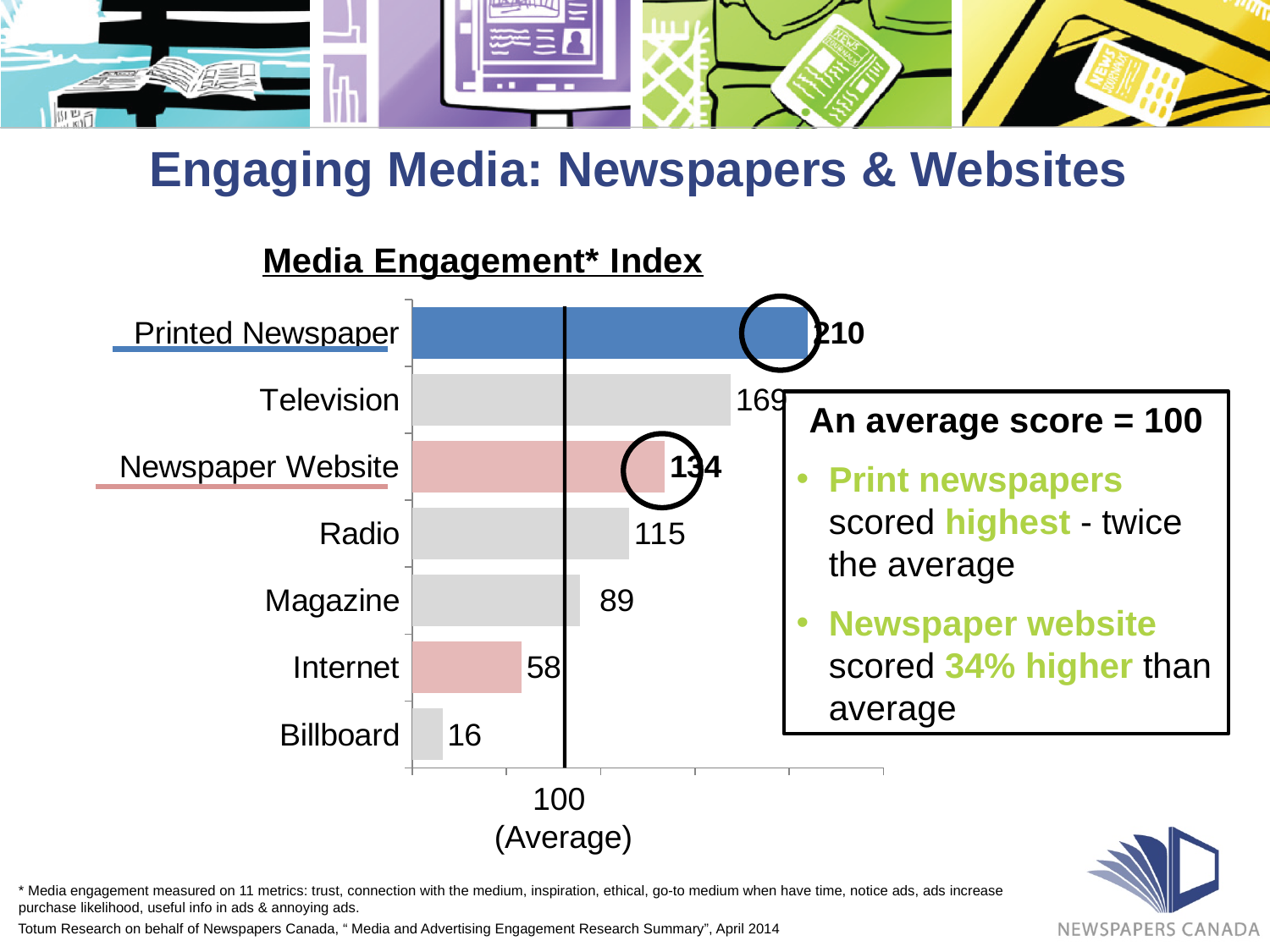
Which medium has the lowest Media Engagement Index? Billboard What is the Media Engagement Index value for Billboard? 16 What is the Media Engagement Index value for Printed Newspaper? 210 How many media categories are shown in the Media Engagement Index chart? 7 What value does the vertical line on the chart mark? 100 (Average) Is the Media Engagement Index value for Magazine greater or less than 100? less What is the Media Engagement Index value for Radio? 115 What type of chart is used to show the Media Engagement Index? bar chart Which has a higher Media Engagement Index, Magazine or Radio? Radio What is the difference between the Media Engagement Index values for Printed Newspaper and Television? 41 Which medium has the highest Media Engagement Index? Printed Newspaper What is the difference between the Media Engagement Index values for Newspaper Website and Internet? 76